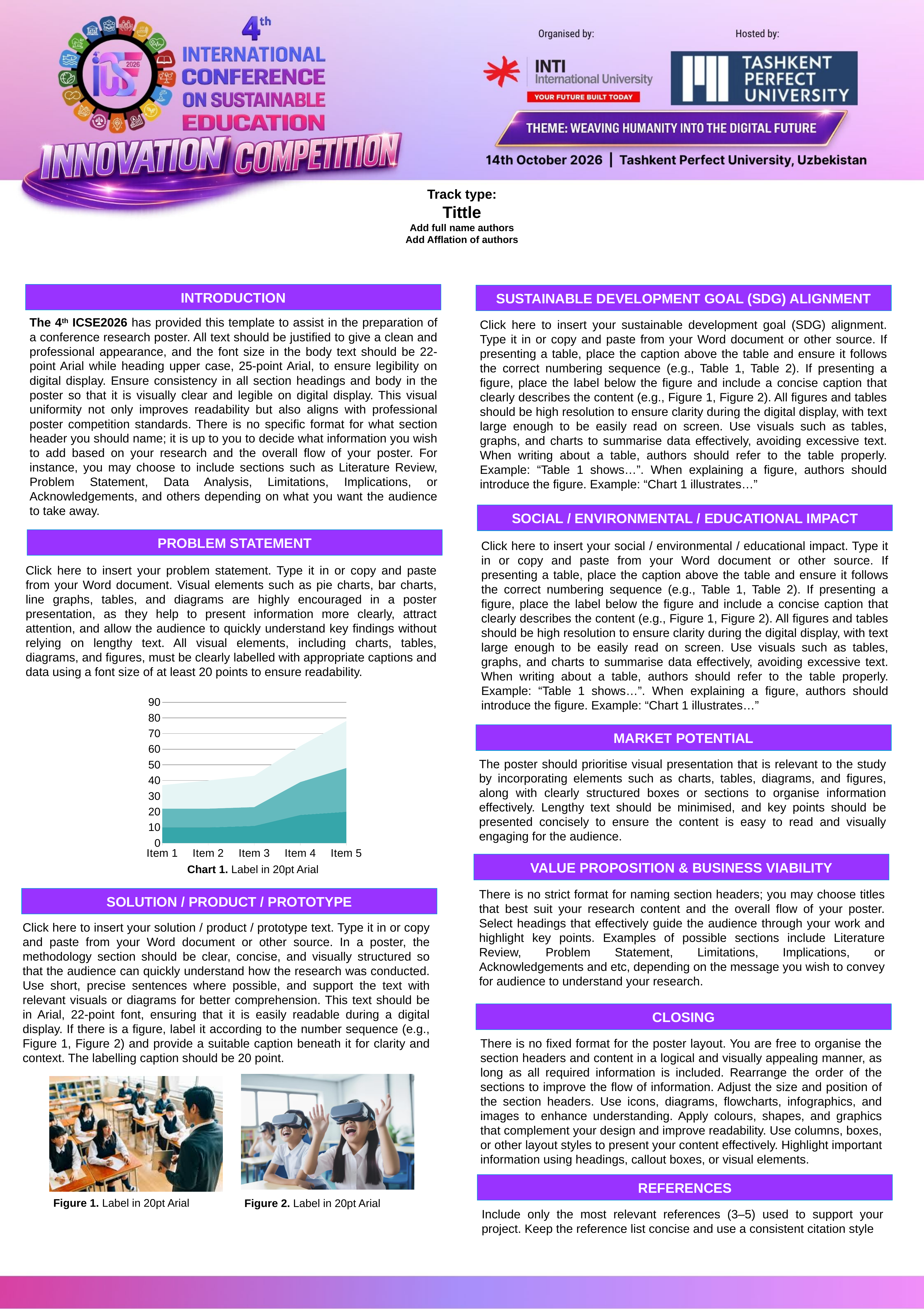
In Chart 1, is the total stacked value for Item 5 larger than that for Item 2? Yes In Chart 1, is the total stacked value for Item 1 greater or less than 50? less In Chart 1, do the stacked values generally rise or fall from Item 1 to Item 5? Rise In Chart 1, which item has the highest total stacked value? Item 5 What is the caption printed below the chart on the slide? Chart 1. Label in 20pt Arial What kind of chart is Chart 1 on the slide? Area chart In Chart 1, is the total stacked value for Item 3 greater or less than 60? less In Chart 1, is the total stacked value for Item 4 greater or less than 50? greater What is the highest tick value shown on the y axis of Chart 1? 90 How many categories are shown on the x axis of Chart 1? 5